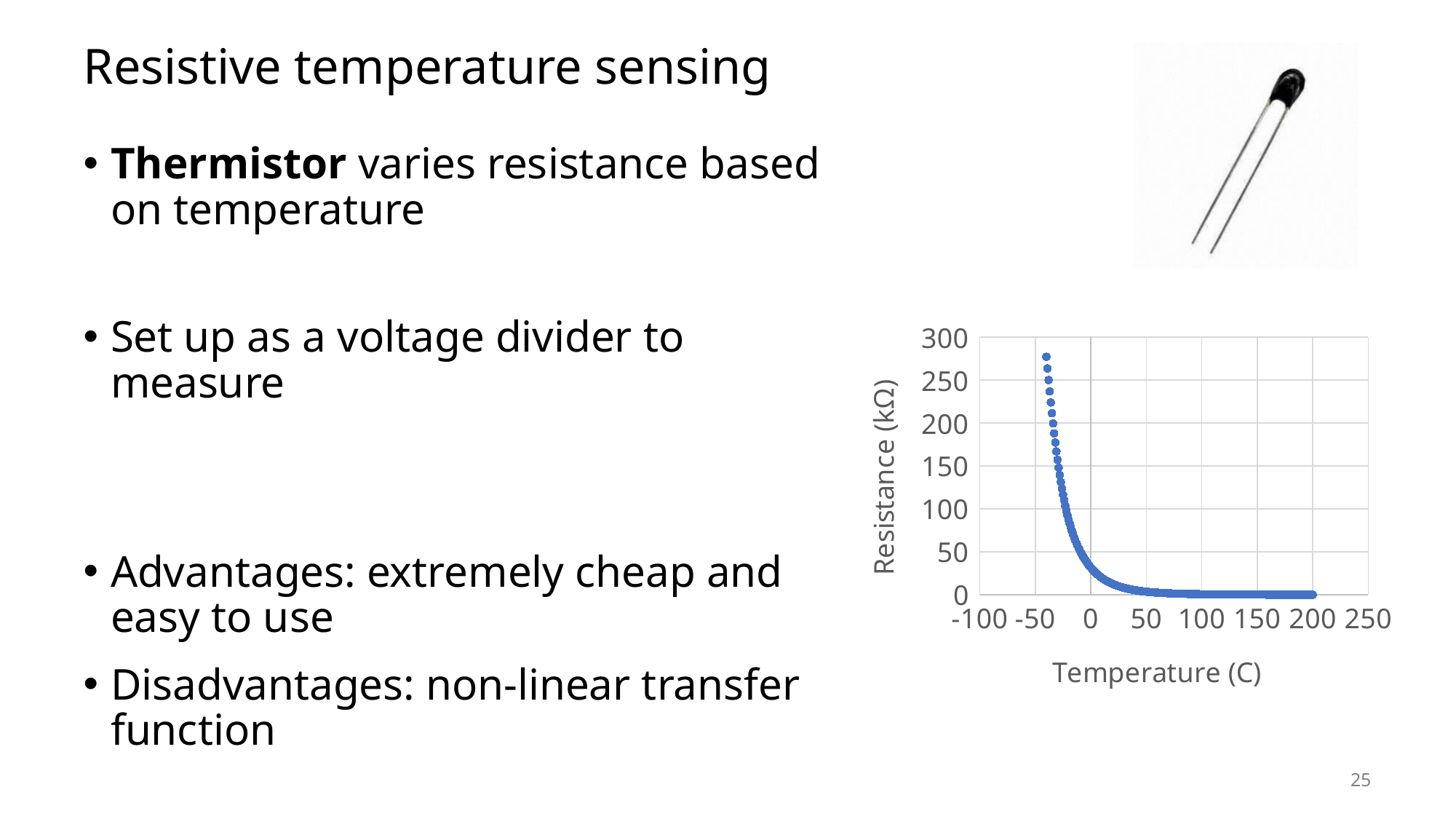
As temperature increases along the x axis, does the resistance rise or fall? fall Is the resistance at a temperature of 0 C greater or less than 100 kΩ? less Is the highest plotted resistance value greater or less than 250 kΩ? greater Is the resistance at a temperature of 200 C greater or less than 50 kΩ? less What is the maximum value shown on the y axis of the chart? 300 What is the label of the x axis of the chart? Temperature (C) Which has the larger resistance: the point at about -40 C or the point at about 50 C? the point at about -40 C What kind of chart is shown on the slide? scatter chart What is the label of the y axis of the chart? Resistance (kΩ)